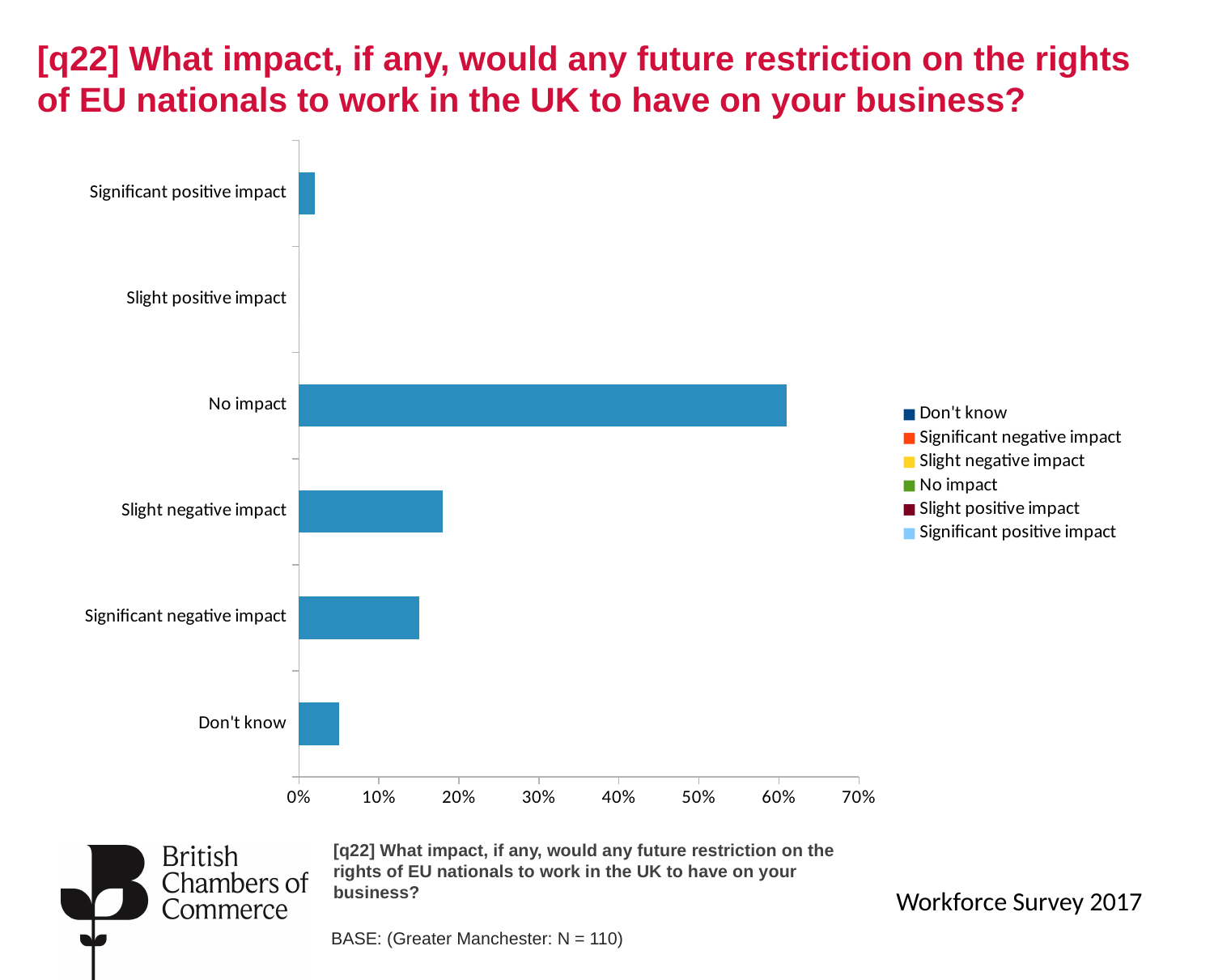
Which category has the highest value? No impact Which category has the lowest value? Slight positive impact How many categories are plotted on the chart? 6 Is the value for Slight negative impact greater or less than 20%? less Is the value for No impact greater or less than 50%? greater Is the value for Significant negative impact greater or less than 10%? greater What is the highest value shown on the horizontal axis? 70% Which is larger, the value for No impact or the value for Slight negative impact? No impact How many entries does the legend list? 6 What kind of chart is shown on the slide? Bar chart Which is larger, the value for Don't know or the value for Significant positive impact? Don't know